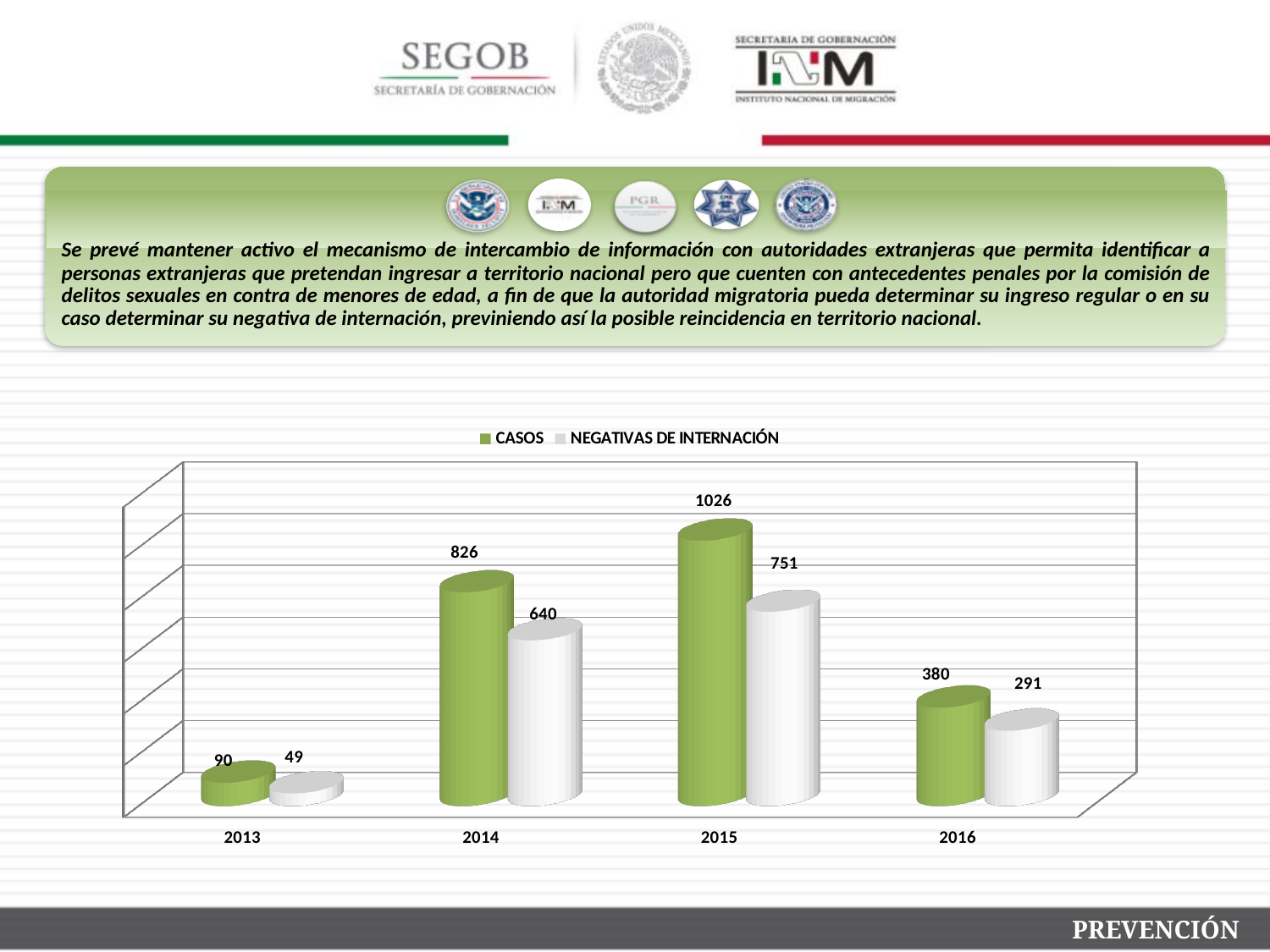
Which year has the lowest value for NEGATIVAS DE INTERNACIÓN? 2013 What is the value of CASOS for 2015? 1026 How many years are shown on the x axis? 4 What is the value of CASOS for 2013? 90 What is the value of NEGATIVAS DE INTERNACIÓN for 2016? 291 What is the value of NEGATIVAS DE INTERNACIÓN for 2014? 640 Which is larger: NEGATIVAS DE INTERNACIÓN in 2014 or CASOS in 2016? NEGATIVAS DE INTERNACIÓN in 2014 What is the difference between CASOS and NEGATIVAS DE INTERNACIÓN in 2015? 275 What kind of chart is shown on the slide? Bar chart Which year has the highest value for CASOS? 2015 How many series does the legend list? 2 What is the difference between CASOS in 2014 and CASOS in 2016? 446